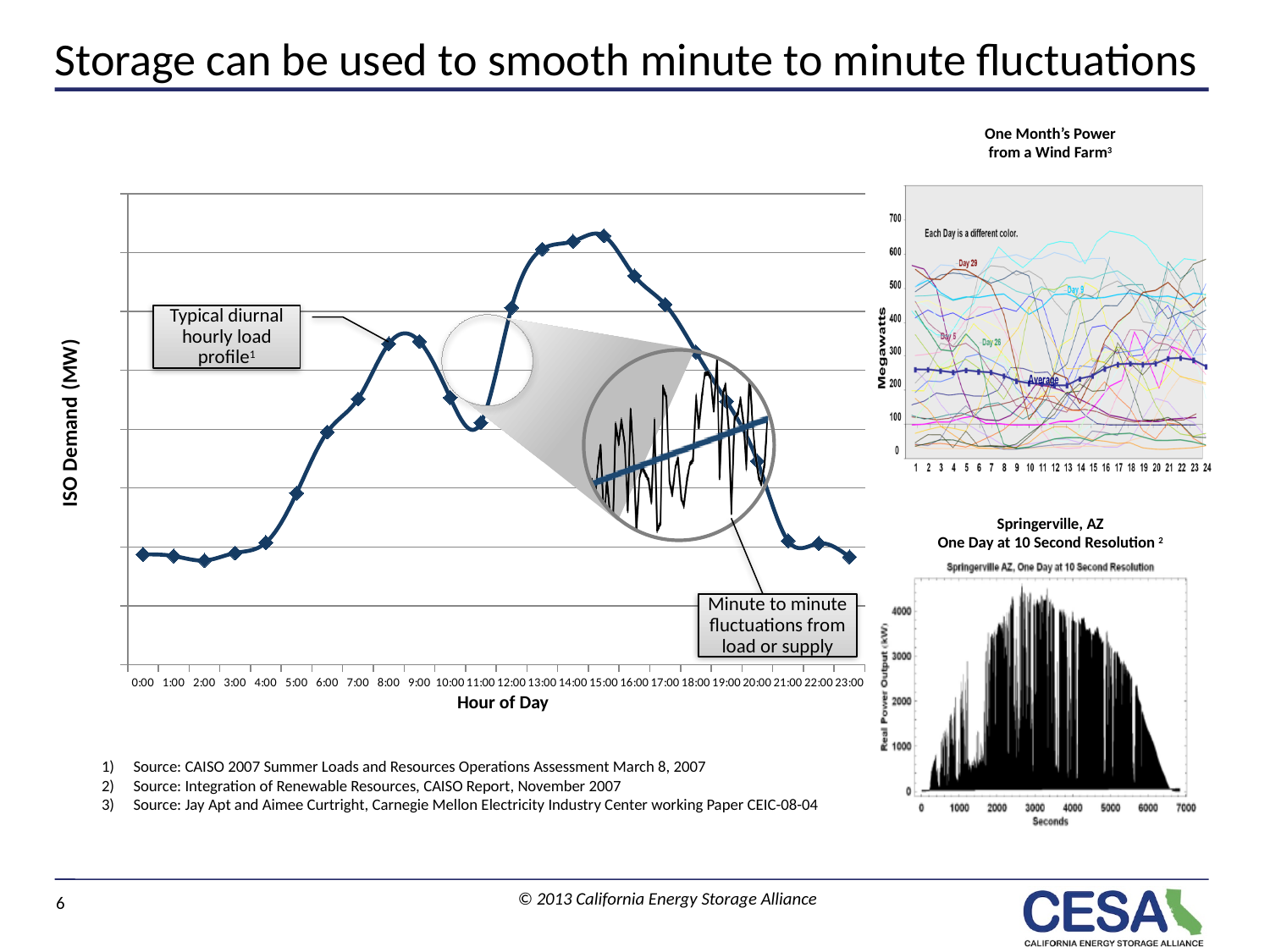
In the main chart on the left, is ISO demand higher at 8:00 or at 15:00? 15:00 In the main chart on the left, at which hour of day is ISO demand lowest? 2:00 In the main chart on the left, is ISO demand higher at 5:00 or at 10:00? 10:00 What kind of chart is the main chart on the left showing ISO Demand by Hour of Day? line chart How many hourly data points are plotted in the main chart on the left? 24 What is the x-axis label of the main chart on the left? Hour of Day In the 'One Month's Power from a Wind Farm' chart, is the Average line at hour 1 greater or less than 200 megawatts? greater In the main chart on the left, does ISO demand rise or fall between 4:00 and 8:00? rise In the 'One Month's Power from a Wind Farm' chart, is the Average line at hour 12 greater or less than 300 megawatts? less In the main chart on the left, at which hour of day does ISO demand reach its highest value? 15:00 In the main chart on the left, does ISO demand rise or fall between 15:00 and 21:00? fall In the 'Springerville, AZ One Day at 10 Second Resolution' chart, is the peak real power output greater or less than 4000 kW? greater